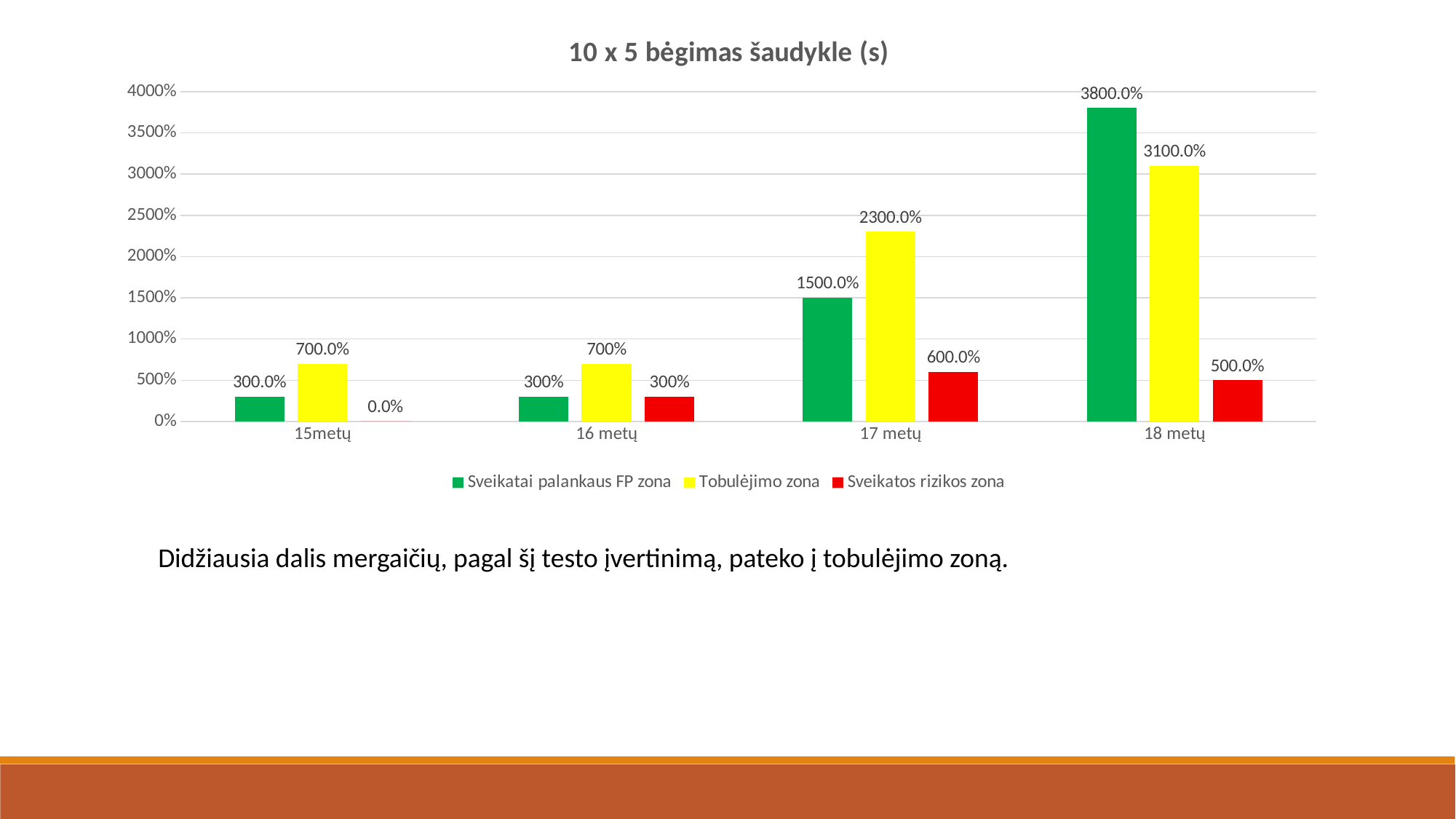
How many age groups are shown on the x axis? 4 For 17 metų, which is larger: Sveikatai palankaus FP zona or Tobulėjimo zona? Tobulėjimo zona How many series does the legend list? 3 What is the value of Tobulėjimo zona for 17 metų? 2300.0% What is the difference between Sveikatai palankaus FP zona and Tobulėjimo zona for 18 metų? 700.0% What is the title of the chart? 10 x 5 bėgimas šaudykle (s) What kind of chart is shown on the slide? Bar chart Which age group has the lowest value for Sveikatos rizikos zona? 15metų Which age group has the highest value for Tobulėjimo zona? 18 metų What is the value of Sveikatai palankaus FP zona for 18 metų? 3800.0% What is the value of Sveikatos rizikos zona for 16 metų? 300% What is the value of Sveikatos rizikos zona for 15metų? 0.0%